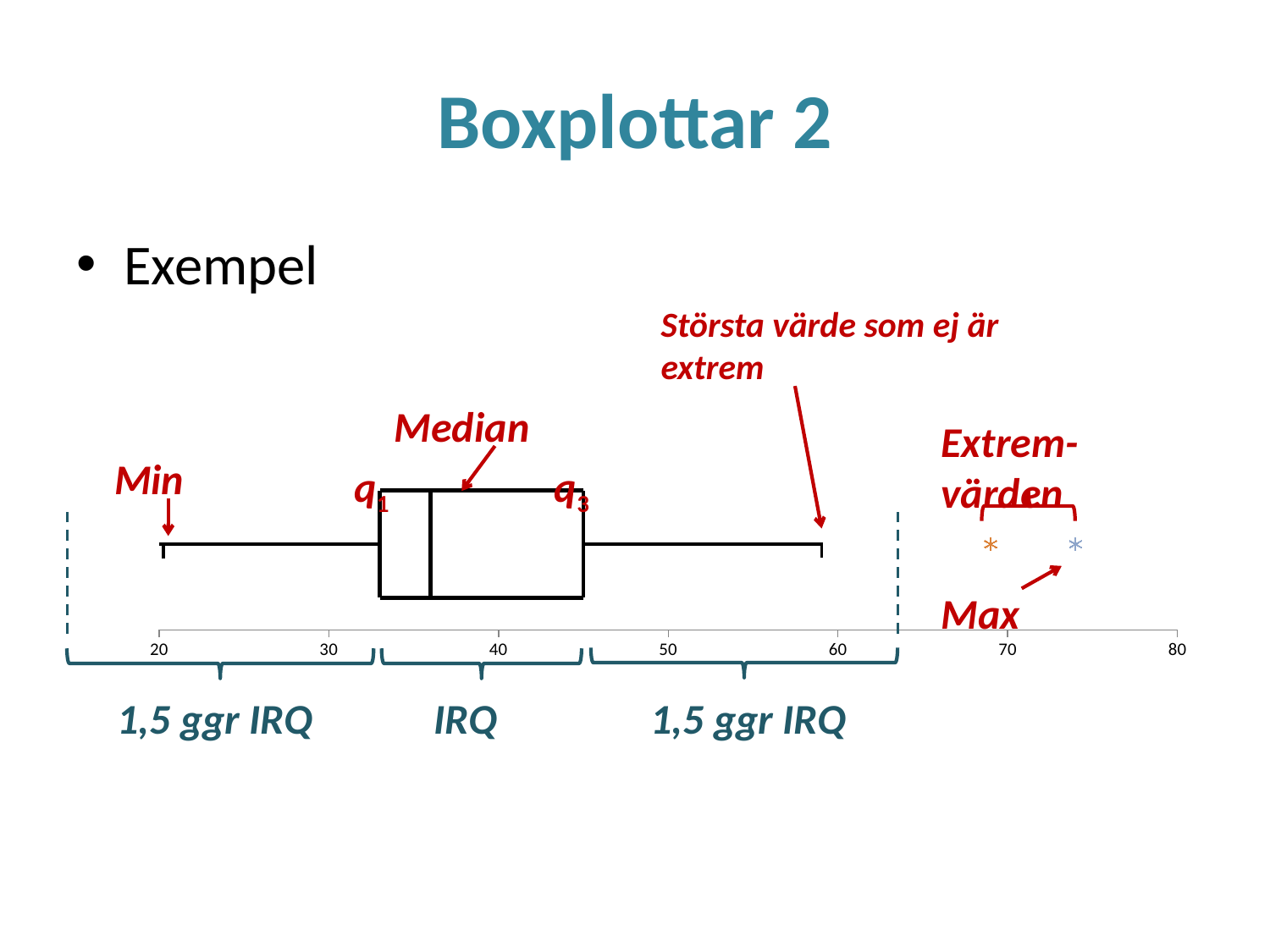
Is the largest non-extreme value (right end of the whisker) greater or less than 50? greater Are the extreme values (asterisks) greater or less than 60? greater Is the value of q3 (the right edge of the box) greater or less than 40? greater What is the lowest value shown on the horizontal axis? 20 How many extreme values (asterisks) are plotted to the right of the box plot? 2 What kind of chart is shown on the slide? box plot Is the median closer to q1 or to q3? q1 What is the highest value shown on the horizontal axis? 80